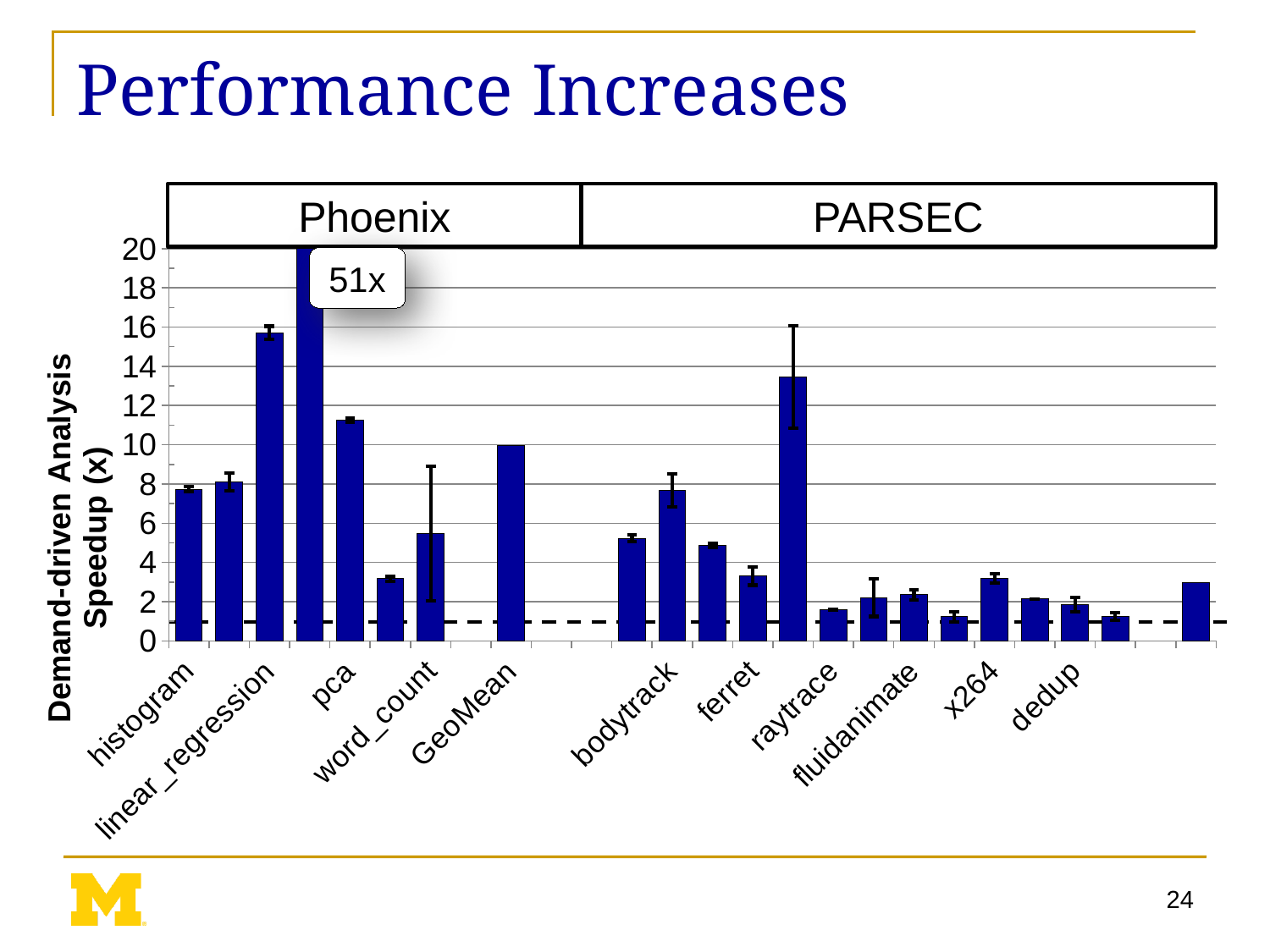
Is the value for ferret greater or less than 6? less What value is annotated on the tallest bar in the chart? 51x What is the title of the vertical axis of the chart? Demand-driven Analysis Speedup (x) Is the value for GeoMean greater or less than 8? greater Is the value for bodytrack greater or less than 4? greater Which benchmark group, Phoenix or PARSEC, contains the tallest bar? Phoenix What is the highest tick value shown on the vertical axis? 20 What are the two benchmark group labels shown above the chart? Phoenix and PARSEC What kind of chart is shown on the slide? bar chart